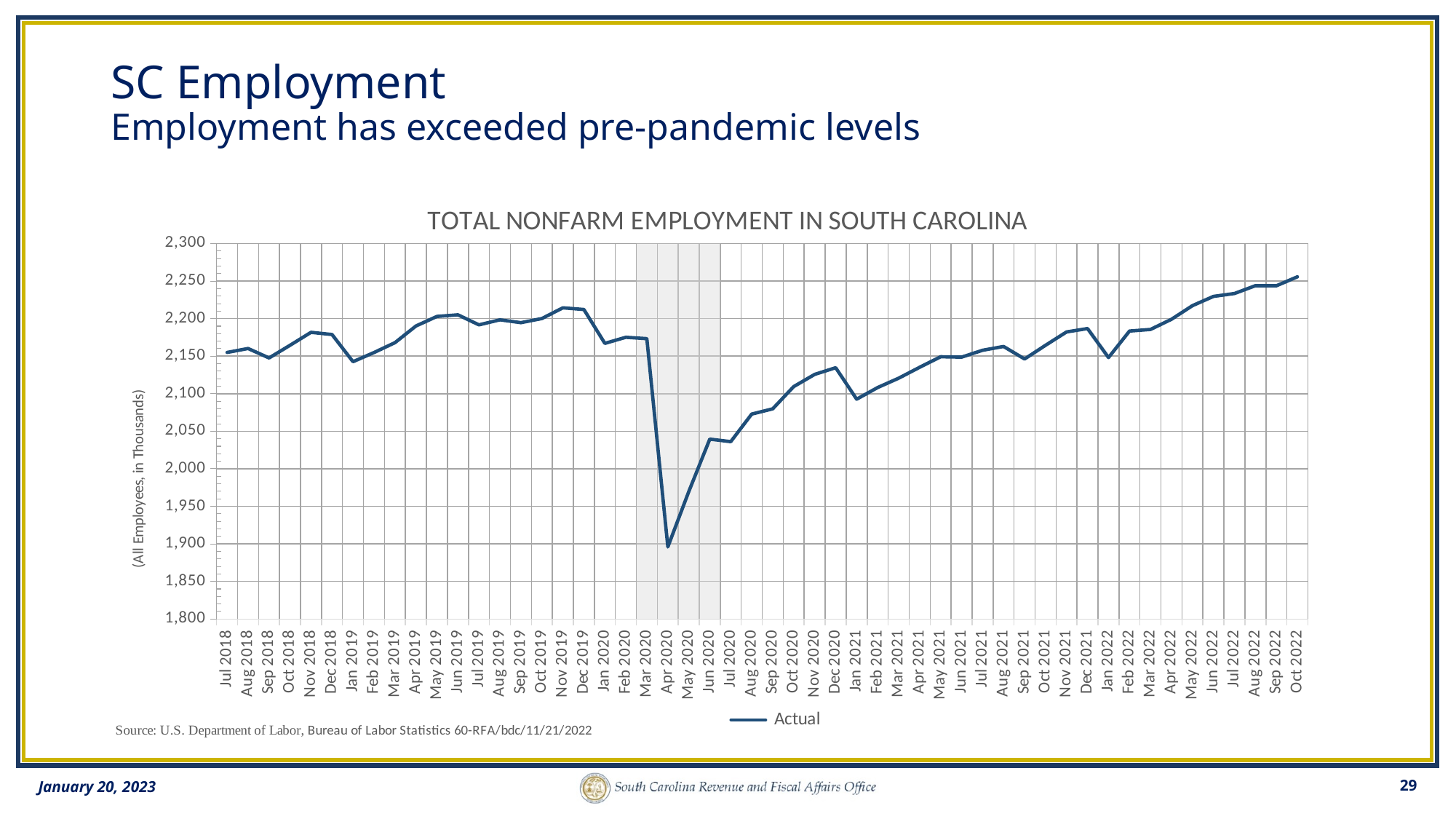
What kind of chart is shown on the slide? Line chart In which month does total nonfarm employment reach its highest point? Oct 2022 Is the value for Apr 2020 greater or less than 1,950? less Is the value for Oct 2022 greater or less than 2,200? greater How many monthly data points are plotted on the chart? 52 From Apr 2020 to Oct 2022, does total nonfarm employment generally rise or fall? rise Is the value for Jun 2020 greater or less than 2,050? less What is the name of the series shown in the legend? Actual In which month does total nonfarm employment reach its lowest point? Apr 2020 How many series does the chart legend list? 1 Which is higher, the value for Nov 2019 or the value for Jan 2021? Nov 2019 What is the title of the chart? TOTAL NONFARM EMPLOYMENT IN SOUTH CAROLINA